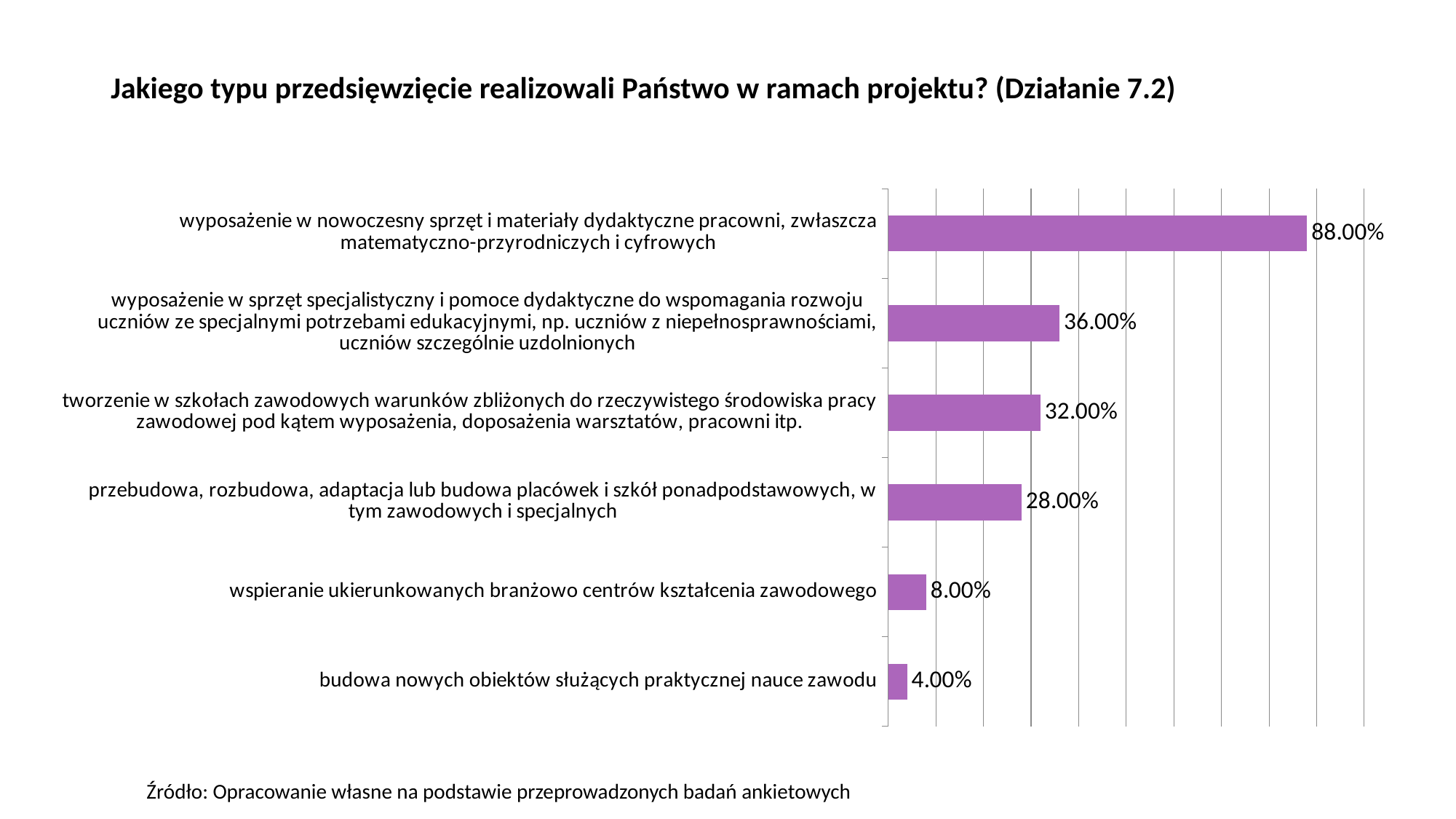
What colour are the bars in the chart? purple What is the title of the chart? Jakiego typu przedsięwzięcie realizowali Państwo w ramach projektu? (Działanie 7.2) What kind of chart is shown on the slide? bar chart Which category has the highest value? wyposażenie w nowoczesny sprzęt i materiały dydaktyczne pracowni, zwłaszcza matematyczno-przyrodniczych i cyfrowych What is the value for 'przebudowa, rozbudowa, adaptacja lub budowa placówek i szkół ponadpodstawowych, w tym zawodowych i specjalnych'? 28.00% Which is larger: the value for 'wyposażenie w sprzęt specjalistyczny i pomoce dydaktyczne...' or the value for 'tworzenie w szkołach zawodowych warunków zbliżonych do rzeczywistego środowiska pracy zawodowej...'? wyposażenie w sprzęt specjalistyczny i pomoce dydaktyczne do wspomagania rozwoju uczniów ze specjalnymi potrzebami edukacyjnymi, np. uczniów z niepełnosprawnościami, uczniów szczególnie uzdolnionych How many categories are shown in the chart? 6 What is the difference between the values for 'wspieranie ukierunkowanych branżowo centrów kształcenia zawodowego' and 'budowa nowych obiektów służących praktycznej nauce zawodu'? 4.00% Which category has the lowest value? budowa nowych obiektów służących praktycznej nauce zawodu What is the value for 'wspieranie ukierunkowanych branżowo centrów kształcenia zawodowego'? 8.00% What is the difference between the highest value (88.00%) and the value for 'wyposażenie w sprzęt specjalistyczny i pomoce dydaktyczne do wspomagania rozwoju uczniów ze specjalnymi potrzebami edukacyjnymi...' (36.00%)? 52.00% What is the value for 'tworzenie w szkołach zawodowych warunków zbliżonych do rzeczywistego środowiska pracy zawodowej pod kątem wyposażenia, doposażenia warsztatów, pracowni itp.'? 32.00%